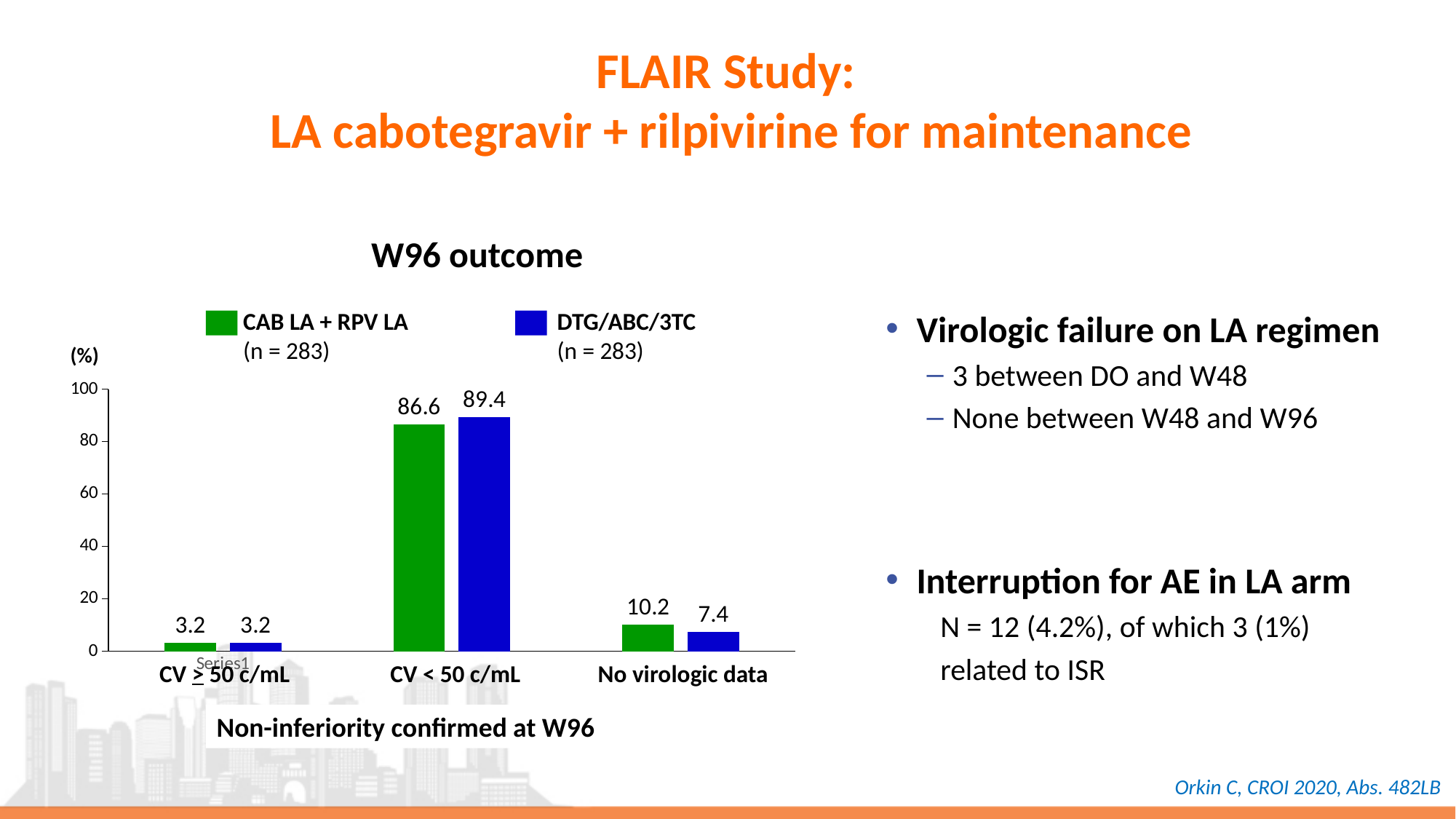
Is the value for CAB LA + RPV LA in the CV < 50 c/mL category greater or less than 80? greater How many series does the legend list? 2 What is the value for CAB LA + RPV LA in the No virologic data category? 10.2 What is the value for CAB LA + RPV LA in the CV < 50 c/mL category? 86.6 What is the value for DTG/ABC/3TC in the CV < 50 c/mL category? 89.4 What is the difference between DTG/ABC/3TC and CAB LA + RPV LA in the CV < 50 c/mL category? 2.8 What kind of chart is shown on the slide? Bar chart Which category has the lowest value for CAB LA + RPV LA? CV ≥ 50 c/mL How many categories are shown on the x axis? 3 What is the value for DTG/ABC/3TC in the CV ≥ 50 c/mL category? 3.2 In the No virologic data category, which series has the larger value? CAB LA + RPV LA Which category has the highest value for DTG/ABC/3TC? CV < 50 c/mL